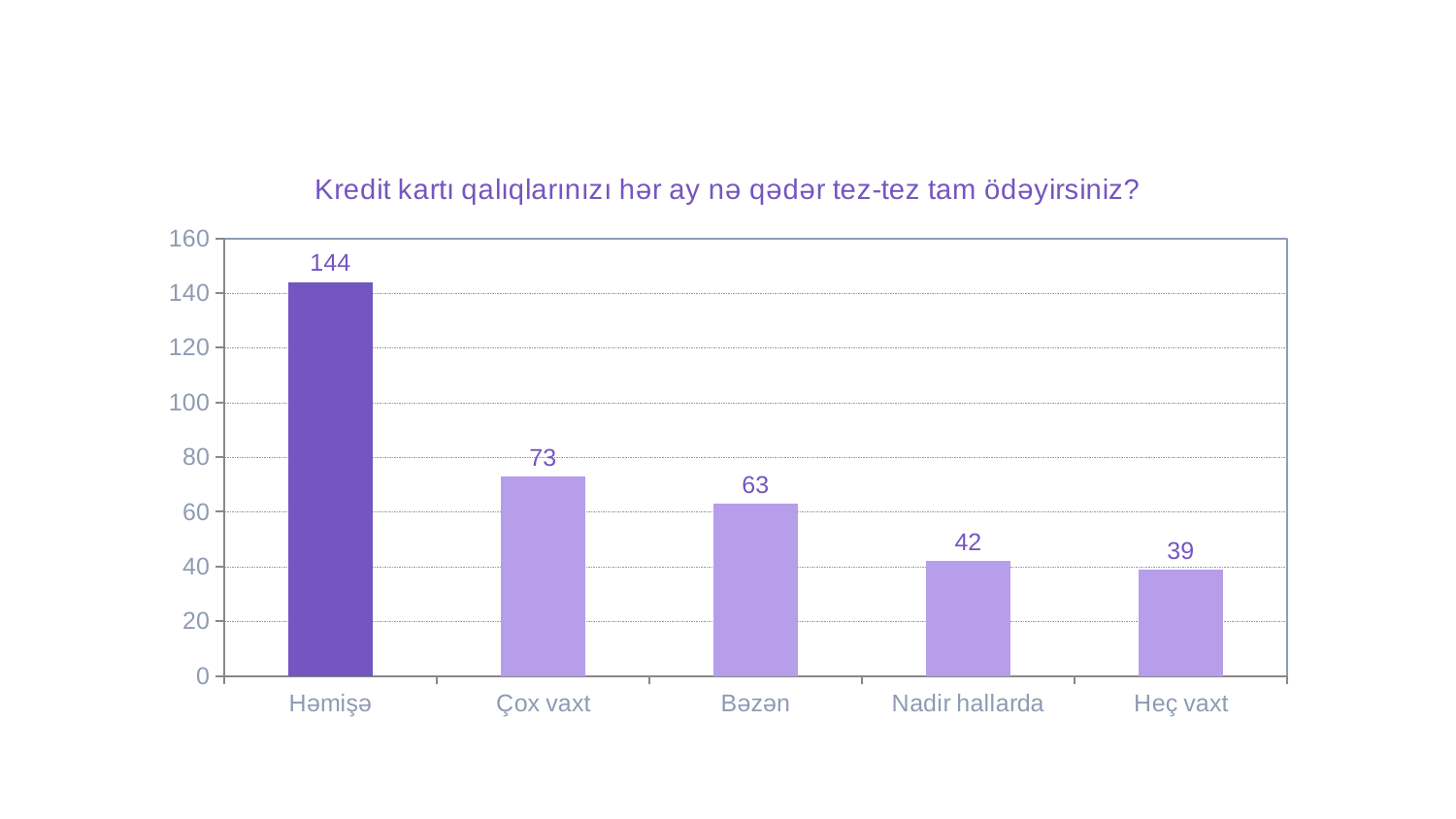
What is the value for Bəzən? 63 How many categories are shown on the x axis? 5 Which category has the lowest value? Heç vaxt What is the difference between the values for Həmişə and Çox vaxt? 71 What kind of chart is shown on the slide? Bar chart What is the title of the chart? Kredit kartı qalıqlarınızı hər ay nə qədər tez-tez tam ödəyirsiniz? What is the value for Həmişə? 144 Which category has the highest value? Həmişə Which is larger, the value for Bəzən or the value for Nadir hallarda? Bəzən What is the value for Çox vaxt? 73 What is the value for Nadir hallarda? 42 What is the value for Heç vaxt? 39